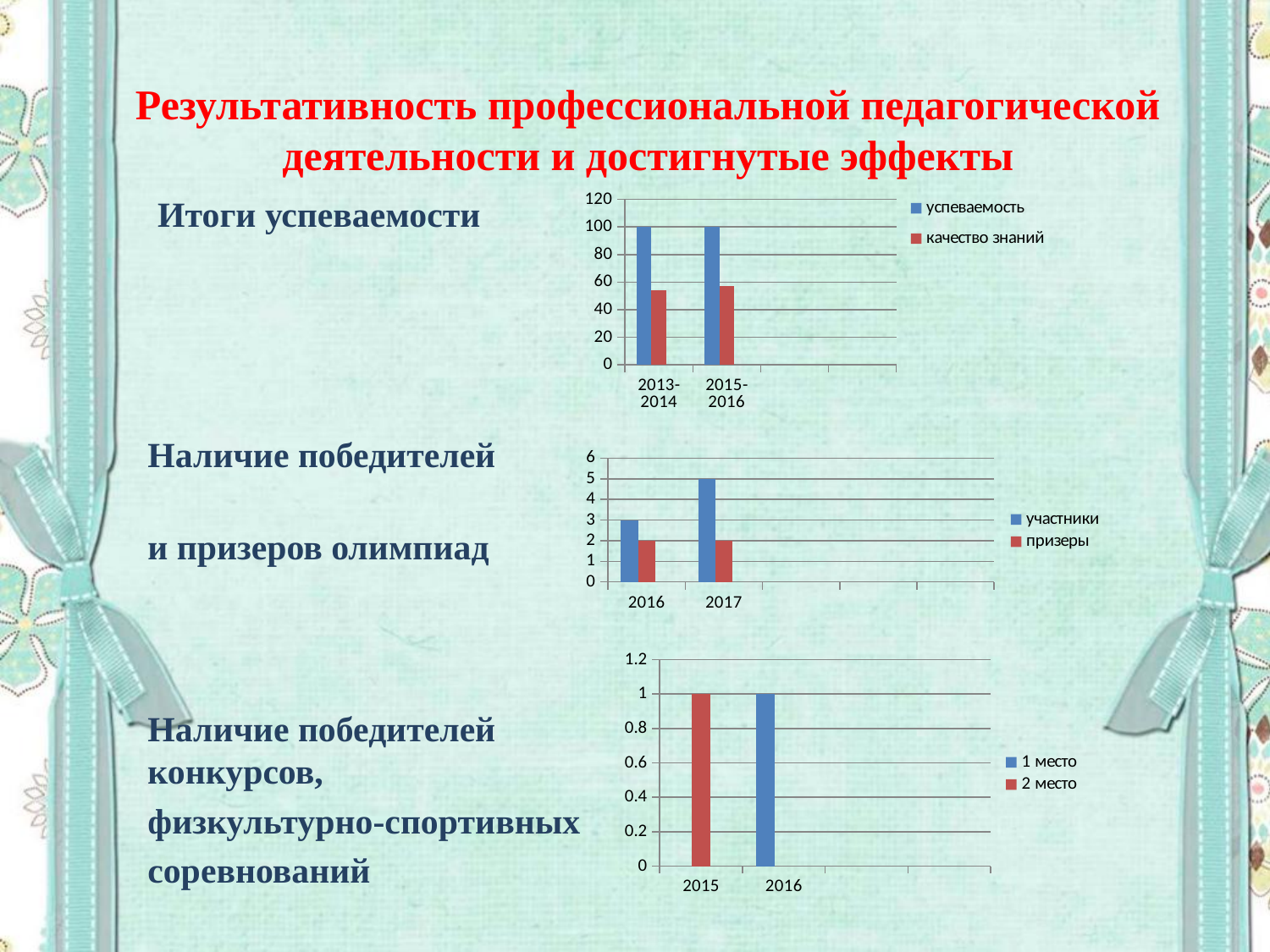
In the bottom chart (competition winners), which series has a bar for 2016? 1 место In the middle chart (olympiad winners), what is the value of участники for 2017? 5 In the middle chart (olympiad winners), what is the value of призеры for 2016? 2 In the top chart (Итоги успеваемости), what is the value of успеваемость for 2015-2016? 100 In the top chart (Итоги успеваемости), how many series does the legend list? 2 In the bottom chart (competition winners), what is the value of 2 место for 2015? 1 In the top chart (Итоги успеваемости), is the value of качество знаний for 2013-2014 greater or less than 40? greater In the top chart (Итоги успеваемости), is the value of качество знаний for 2015-2016 greater or less than 80? less In the middle chart (olympiad winners), does the number of участники rise or fall from 2016 to 2017? rise What type of chart is the bottom chart (competition winners)? bar chart In the middle chart (olympiad winners), what is the difference between участники in 2017 and участники in 2016? 2 In the top chart (Итоги успеваемости), what is the value of успеваемость for 2013-2014? 100